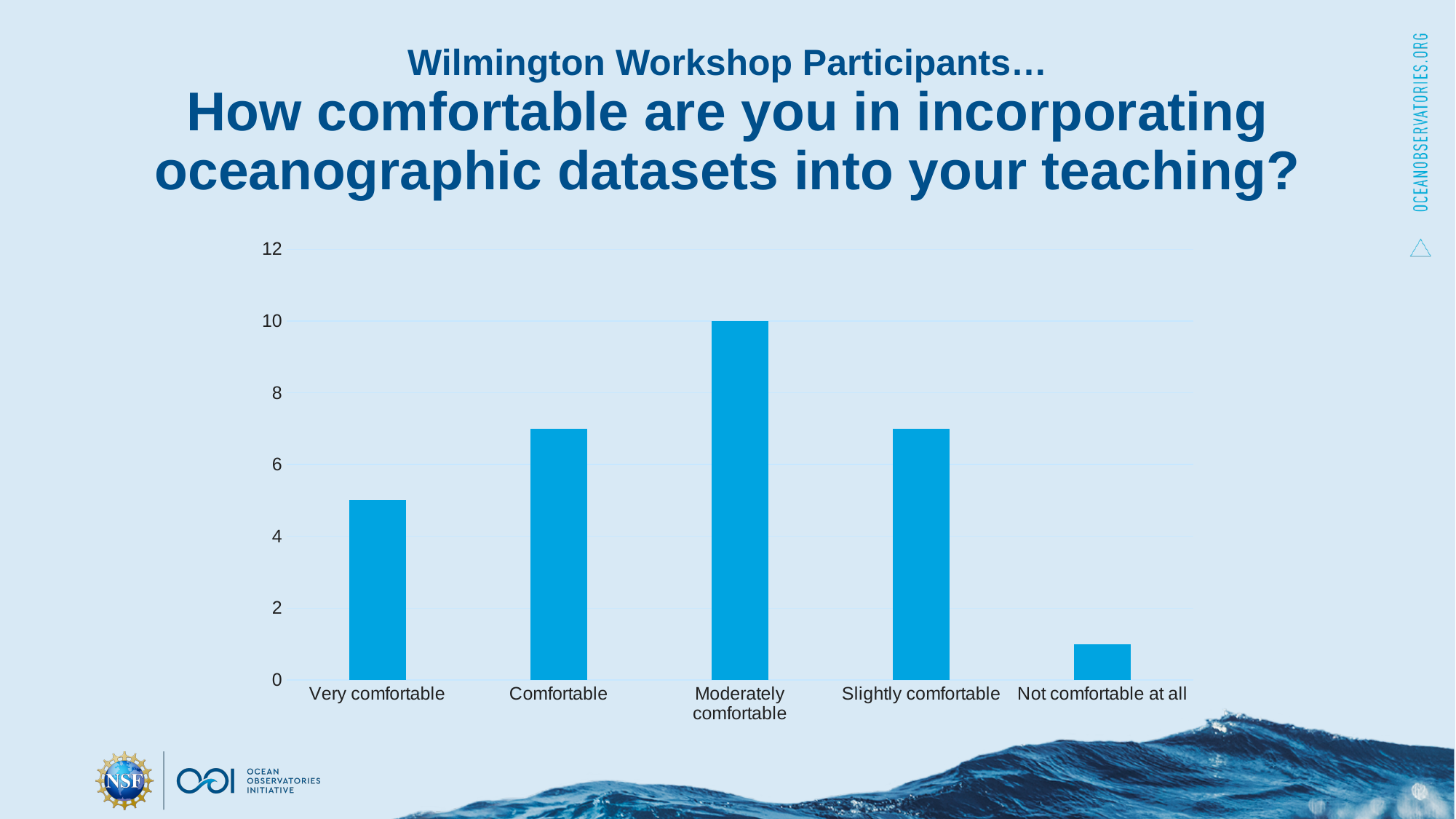
Which category has the highest bar? Moderately comfortable Is the value for Comfortable greater or less than 6? greater Which is larger, the value for Very comfortable or the value for Comfortable? Comfortable How many categories are shown on the x axis of the chart? 5 Is the value for Not comfortable at all greater or less than 2? less Which is larger, the value for Moderately comfortable or the value for Slightly comfortable? Moderately comfortable Which category has the lowest bar? Not comfortable at all What is the highest value shown on the vertical axis of the chart? 12 Is the value for Very comfortable greater or less than 6? less What is the value for Moderately comfortable? 10 What kind of chart is shown on the slide? bar chart